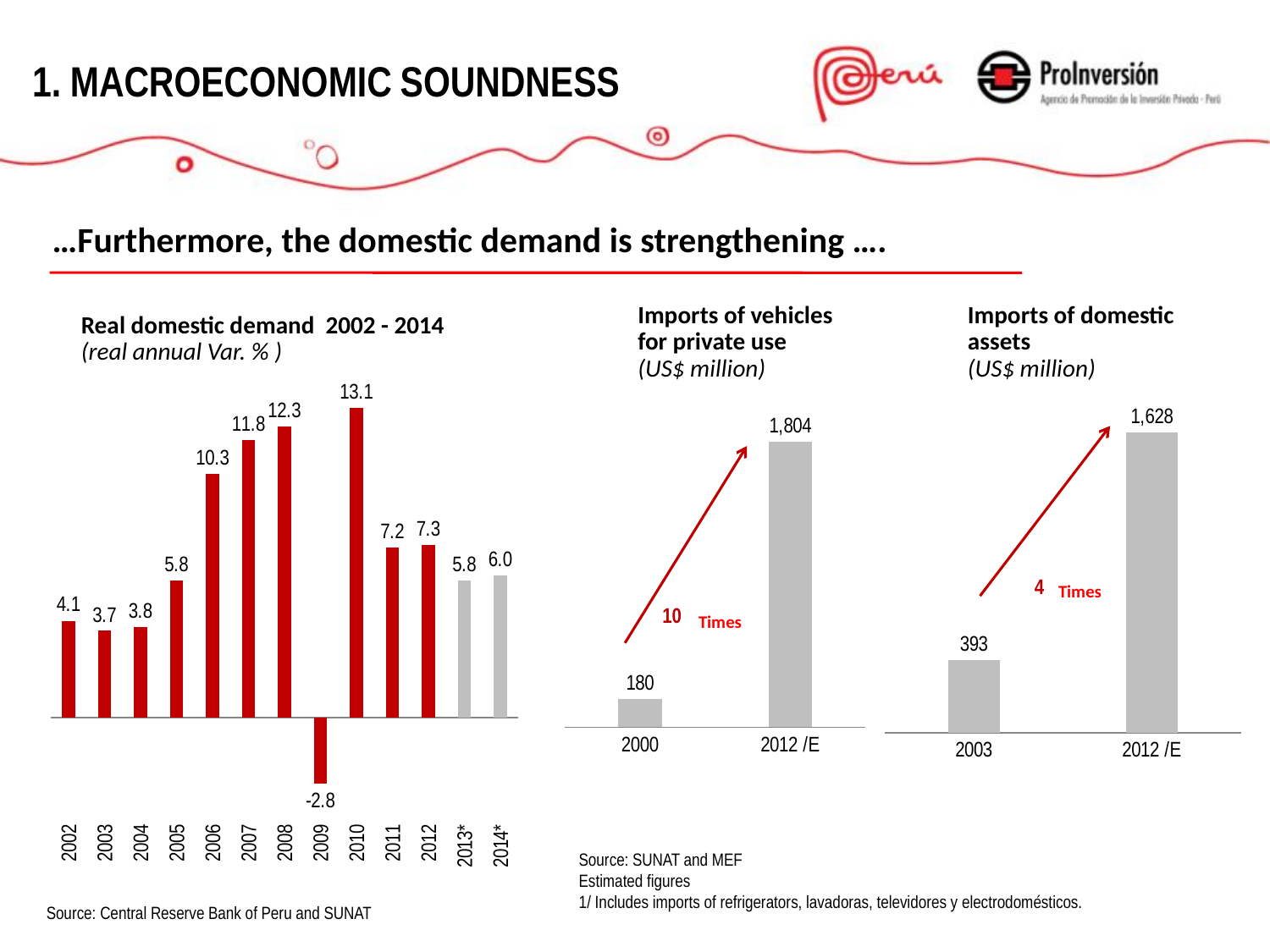
In the 'Real domestic demand 2002 - 2014' chart, is the value for 2006 larger than the value for 2011? Yes In the 'Imports of domestic assets' chart, what is the value for 2003? 393 In the 'Real domestic demand 2002 - 2014' chart, what is the value for 2009? -2.8 In the 'Real domestic demand 2002 - 2014' chart, how many years are shown on the x axis? 13 In the 'Real domestic demand 2002 - 2014' chart, which year has the lowest value? 2009 In the 'Real domestic demand 2002 - 2014' chart, what is the value for 2010? 13.1 In the 'Imports of vehicles for private use' chart, what is the difference between the 2012 /E and 2000 values? 1,624 In the 'Imports of vehicles for private use' chart, what is the value for 2012 /E? 1,804 In the 'Imports of domestic assets' chart, what kind of chart is used? Bar chart In the 'Imports of domestic assets' chart, what multiplier is written next to the red arrow? 4 Times In the 'Real domestic demand 2002 - 2014' chart, what is the difference between the values for 2008 and 2007? 0.5 In the 'Real domestic demand 2002 - 2014' chart, which year has the highest value? 2010